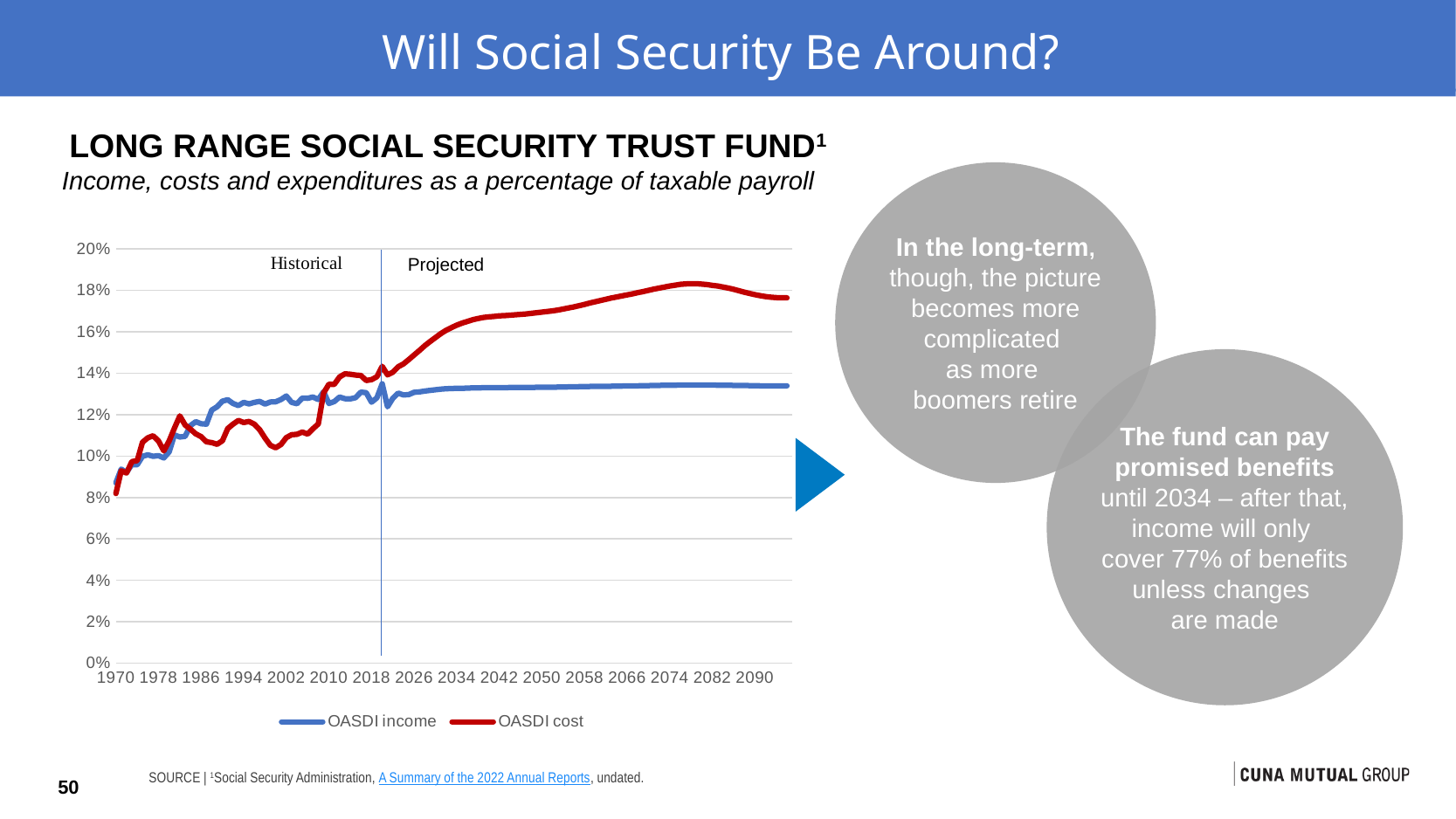
What two labels mark the periods on either side of the vertical line in the chart? Historical and Projected What are the two series named in the chart's legend? OASDI income and OASDI cost Is the value for OASDI income in 1970 greater or less than 10%? less Is the value for OASDI cost in 2090 greater or less than 16%? greater In 2002, which series is higher, OASDI income or OASDI cost? OASDI income What kind of chart is shown on the slide? Line chart How many series does the chart's legend list? 2 What is the highest value labelled on the chart's y axis? 20% Does the OASDI cost line rise or fall between 2026 and 2074? Rise In 2090, which series is higher, OASDI income or OASDI cost? OASDI cost Is the value for OASDI cost in 2002 greater or less than 12%? less